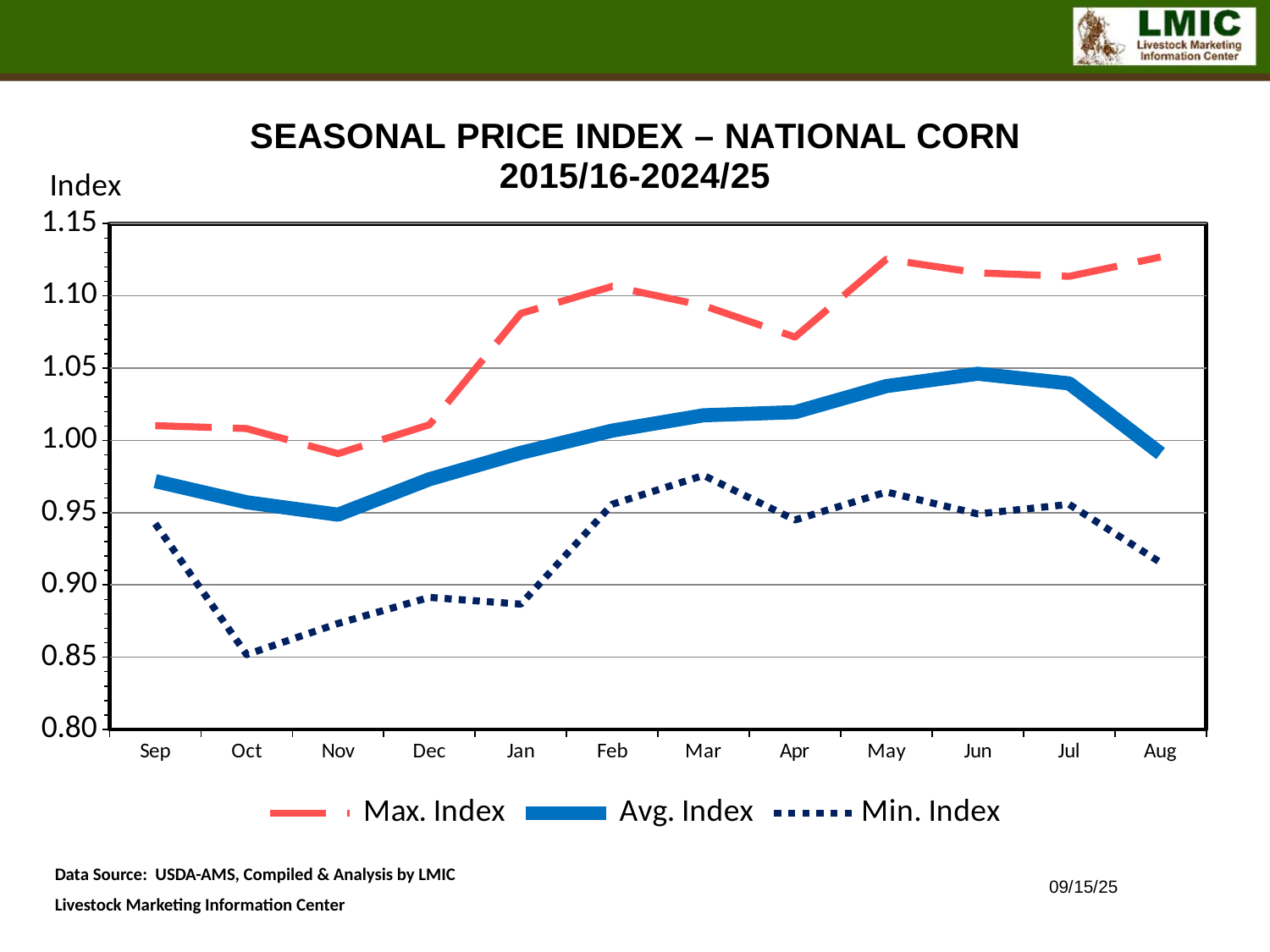
Is the Min. Index value for Oct greater or less than 0.90? less What is the title of the chart? SEASONAL PRICE INDEX – NATIONAL CORN 2015/16-2024/25 In which month is the Min. Index at its lowest? Oct Is the Max. Index value for Feb greater or less than 1.05? greater Which is larger in Jun, the Avg. Index or the Min. Index? Avg. Index Does the Avg. Index rise or fall from Nov to Jun? Rise What kind of chart is shown on the slide? Line chart Is the Avg. Index value for Sep greater or less than 1.00? less In which month is the Max. Index at its lowest? Nov How many series does the legend list? 3 How many months are plotted along the x axis? 12 In which month is the Min. Index at its highest? Mar